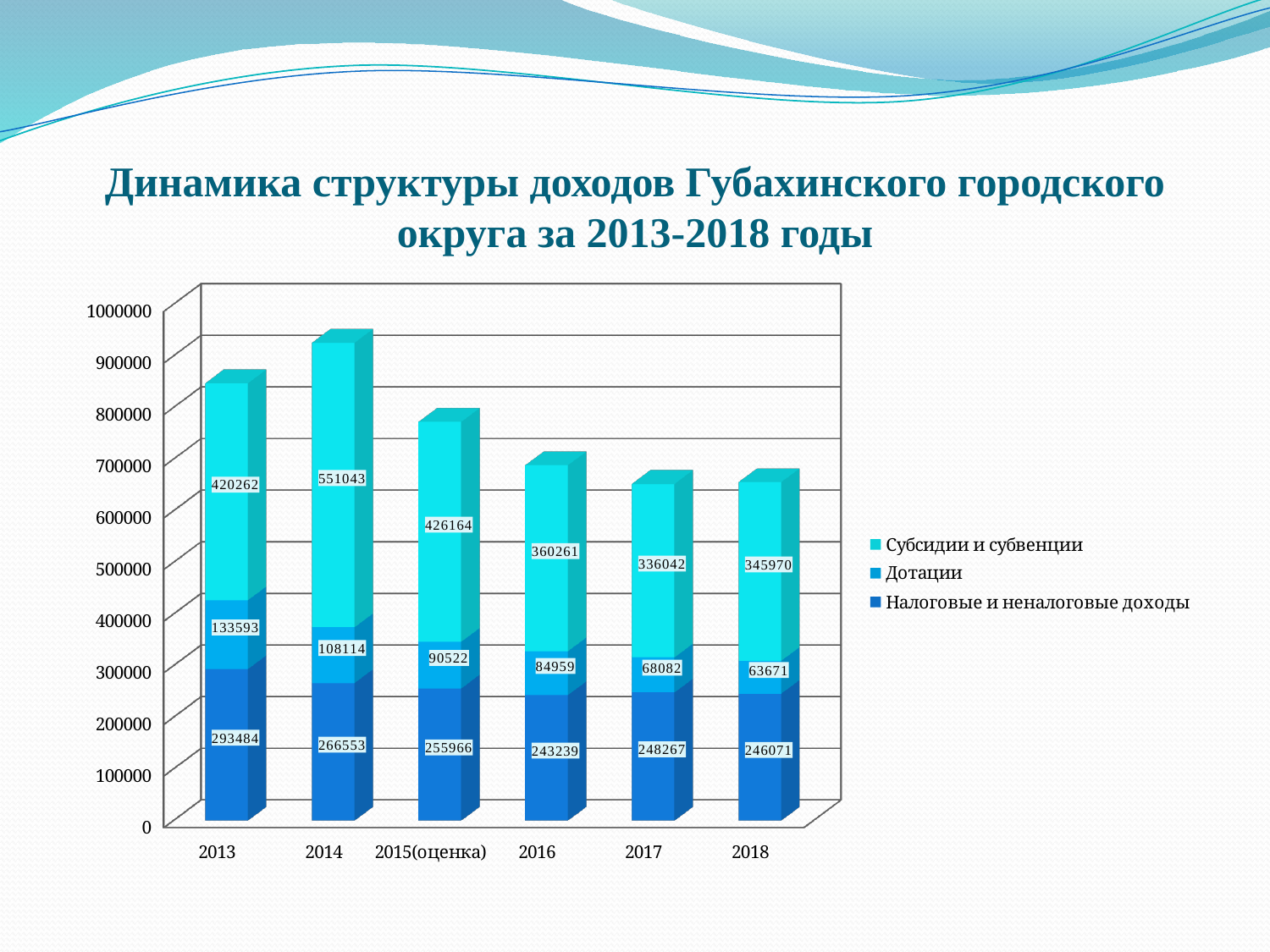
What is the total of the stacked bar for 2013? 847339 What is the value of Налоговые и неналоговые доходы for 2018? 246071 In which year is the value of Дотации lowest? 2018 What kind of chart is shown on the slide? Stacked bar chart How many years are shown on the x axis? 6 Does the value of Дотации rise or fall from 2013 to 2018? Fall What is the value of Дотации for 2016? 84959 Which is larger: Налоговые и неналоговые доходы for 2017 or for 2016? 2017 What is the difference between the Дотации values for 2013 and 2014? 25479 What is the value of Субсидии и субвенции for 2014? 551043 How many series does the legend list? 3 In which year is the value of Субсидии и субвенции highest? 2014